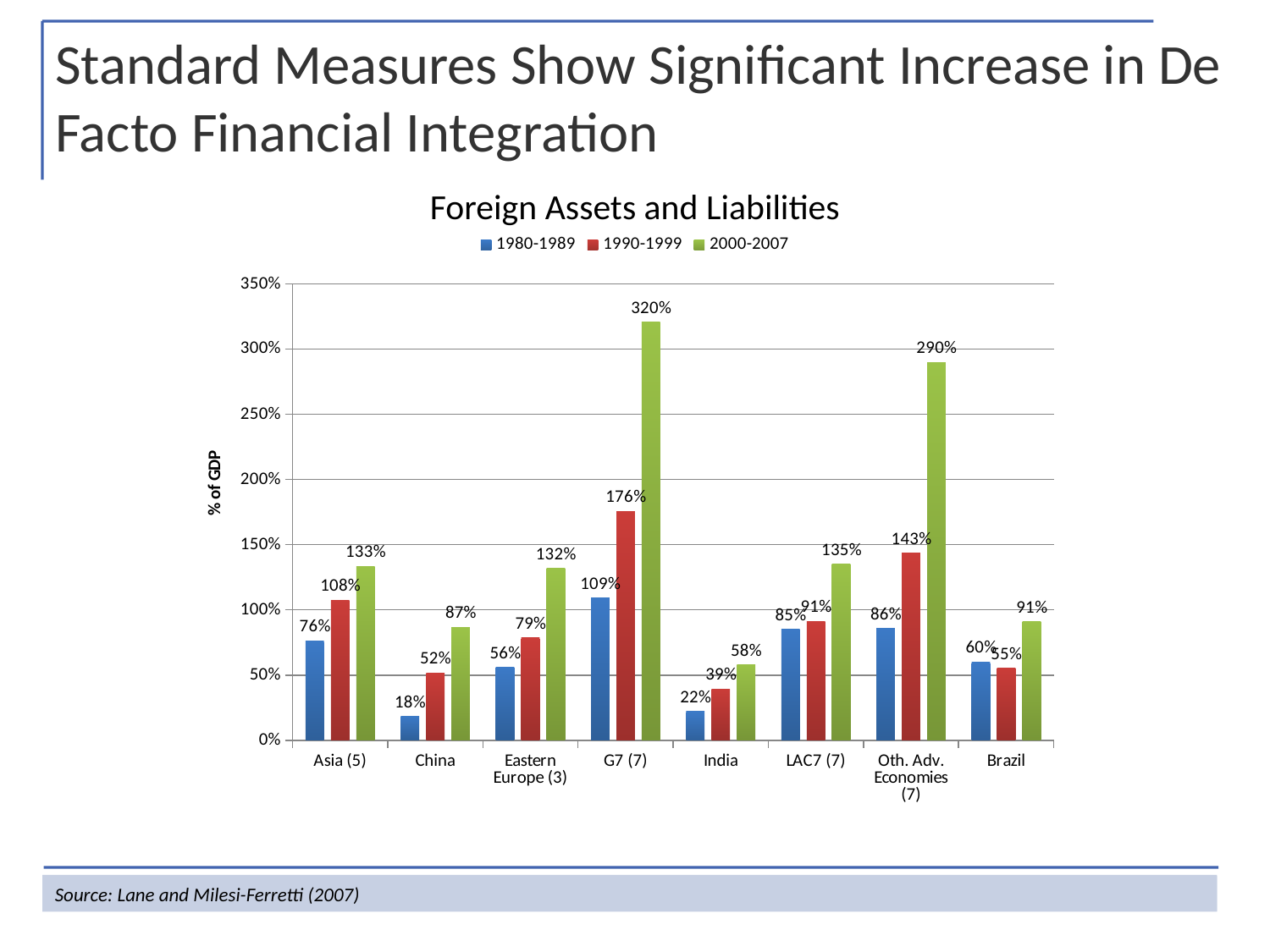
What is the value for Oth. Adv. Economies (7) in the 1990-1999 series? 143% What is the value for China in the 1980-1989 series? 18% How many categories are shown on the x axis? 8 For Brazil, which is larger: the 1980-1989 value or the 1990-1999 value? 1980-1989 What kind of chart is shown on the slide? Bar chart Which category has the lowest value in the 1980-1989 series? China What is the difference between the 2000-2007 and 1980-1989 values for Eastern Europe (3)? 76% What is the value for G7 (7) in the 2000-2007 series? 320% What is the title of the chart? Foreign Assets and Liabilities Is the 2000-2007 value for Oth. Adv. Economies (7) greater or less than 250%? greater How many series does the legend list? 3 Which category has the highest value in the 2000-2007 series? G7 (7)